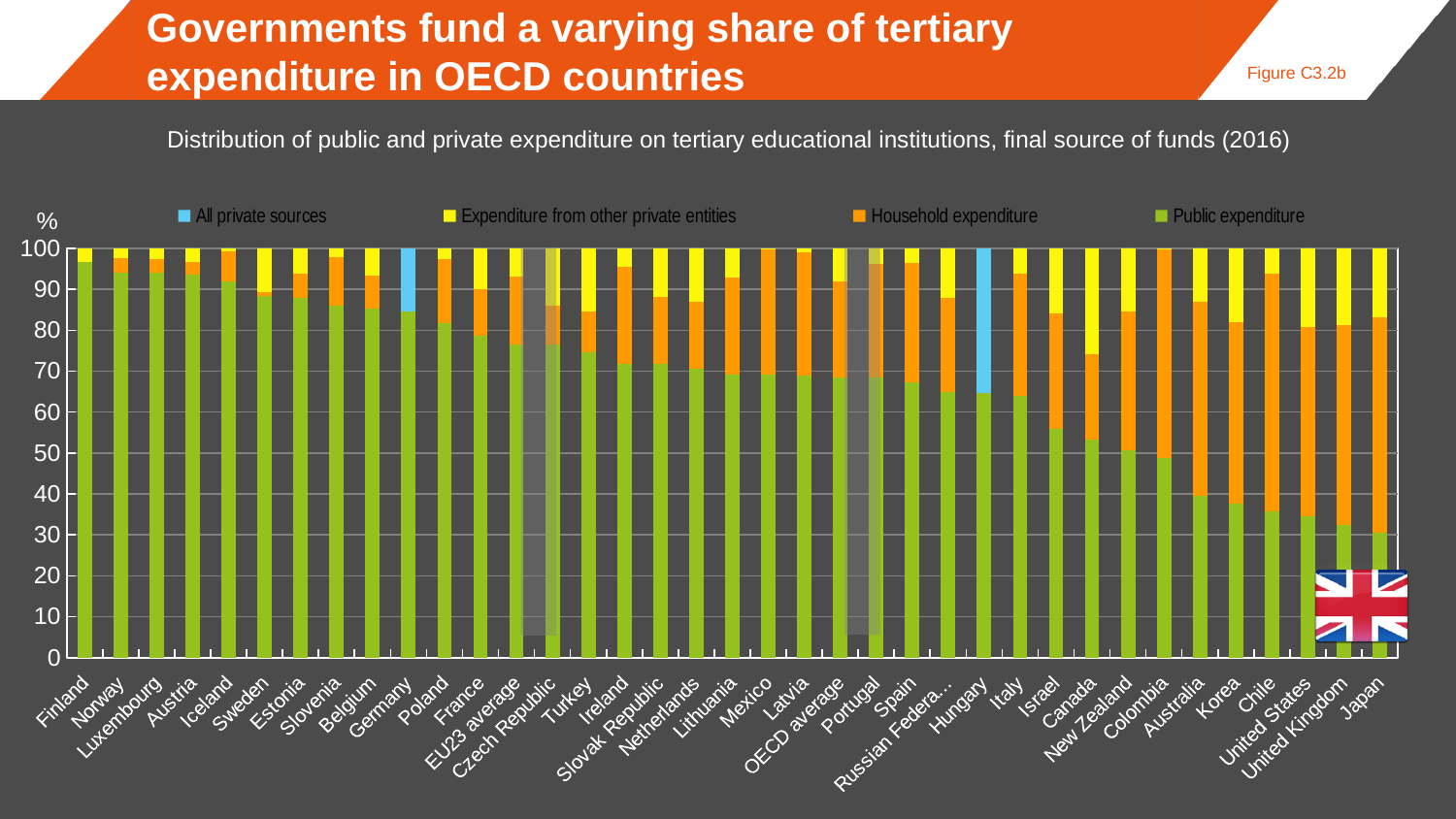
Is the public expenditure share for Finland greater or less than 90? greater Which has a larger public expenditure share, Norway or Chile? Norway What kind of chart is shown on the slide? Stacked bar chart Do the public expenditure shares generally rise or fall from left to right along the x axis? fall Is the public expenditure share for the United Kingdom greater or less than 40? less Which colour represents public expenditure in the legend? Green How many countries or averages are shown along the x axis? 37 Is the public expenditure share for Australia greater or less than 50? less Which country has the lowest share of public expenditure? Japan How many series does the legend list? 4 Which country has the highest share of public expenditure? Finland